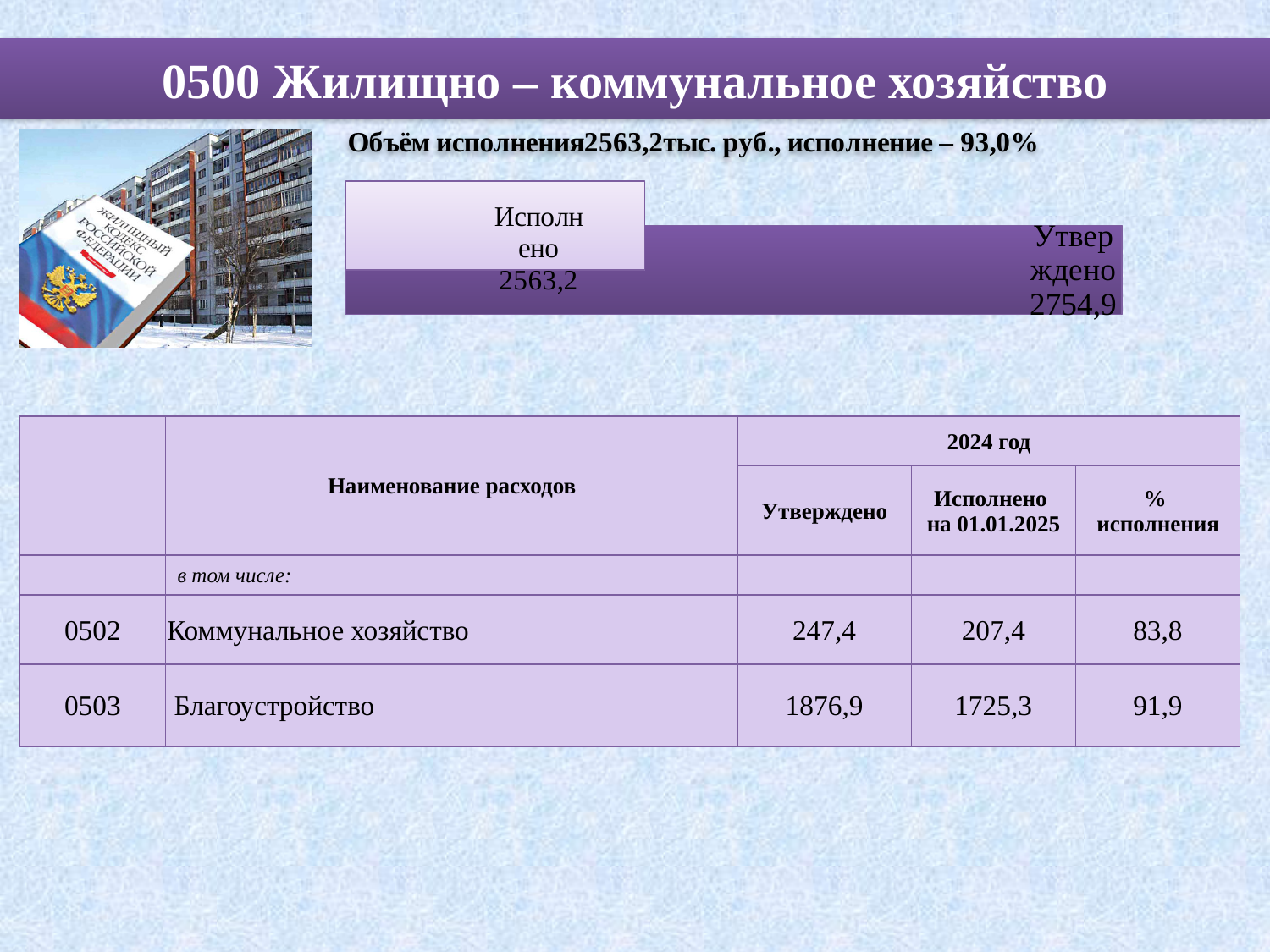
What kind of chart is shown on the slide? bar chart What is the value of the bar labelled Исполнено? 2563,2 Which bar has the higher value, Исполнено or Утверждено? Утверждено What is the value of the bar labelled Утверждено? 2754,9 What is the difference between the Утверждено value and the Исполнено value? 191,7 Which bar has the lower value in the chart? Исполнено Which bar is drawn in the darker purple colour? Утверждено Are the bars in the chart horizontal or vertical? horizontal How many bars does the chart contain? 2 Is the value for Утверждено larger or smaller than the value for Исполнено? larger